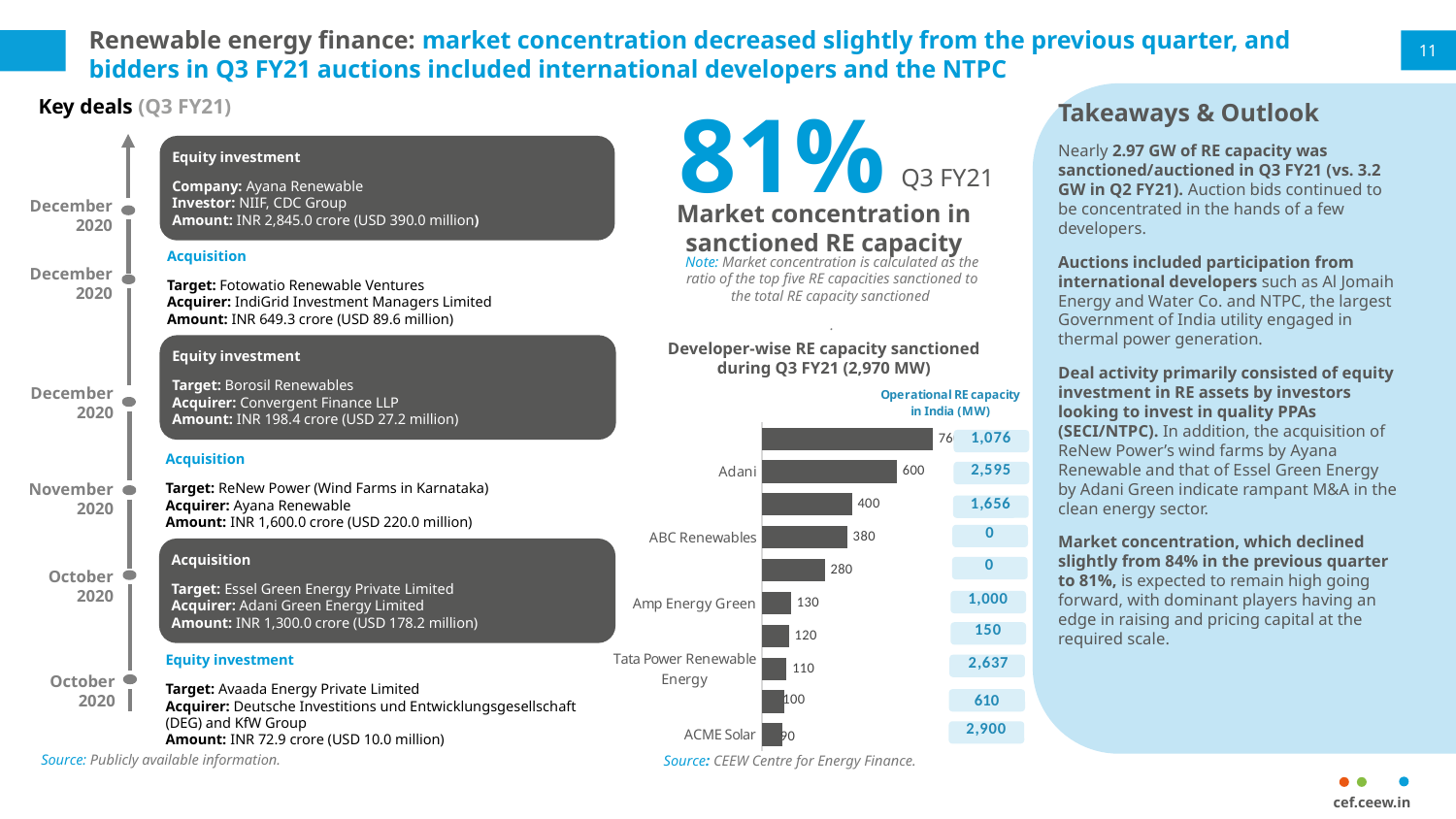
In the 'Developer-wise RE capacity sanctioned during Q3 FY21' chart, what is the sanctioned capacity for Adani? 600 In the 'Developer-wise RE capacity sanctioned during Q3 FY21' chart, what is the sanctioned capacity for Tata Power Renewable Energy? 110 In the 'Operational RE capacity in India (MW)' column next to the chart, what is the value shown for Adani? 2,595 In the 'Developer-wise RE capacity sanctioned during Q3 FY21' chart, what is the difference between the sanctioned capacity of Amp Energy Green and Tata Power Renewable Energy? 20 What type of chart is the 'Developer-wise RE capacity sanctioned during Q3 FY21' chart? Bar chart How many bars are shown in the 'Developer-wise RE capacity sanctioned during Q3 FY21' chart? 10 According to the chart title, what total RE capacity was sanctioned during Q3 FY21? 2,970 MW In the 'Developer-wise RE capacity sanctioned during Q3 FY21' chart, which labelled developer has the lowest sanctioned capacity? ACME Solar In the 'Developer-wise RE capacity sanctioned during Q3 FY21' chart, what is the sanctioned capacity for Amp Energy Green? 130 In the 'Developer-wise RE capacity sanctioned during Q3 FY21' chart, which has a larger sanctioned capacity, Adani or Amp Energy Green? Adani In the 'Developer-wise RE capacity sanctioned during Q3 FY21' chart, what is the sanctioned capacity for ABC Renewables? 380 In the 'Developer-wise RE capacity sanctioned during Q3 FY21' chart, what is the difference between the sanctioned capacity of Adani and ABC Renewables? 220